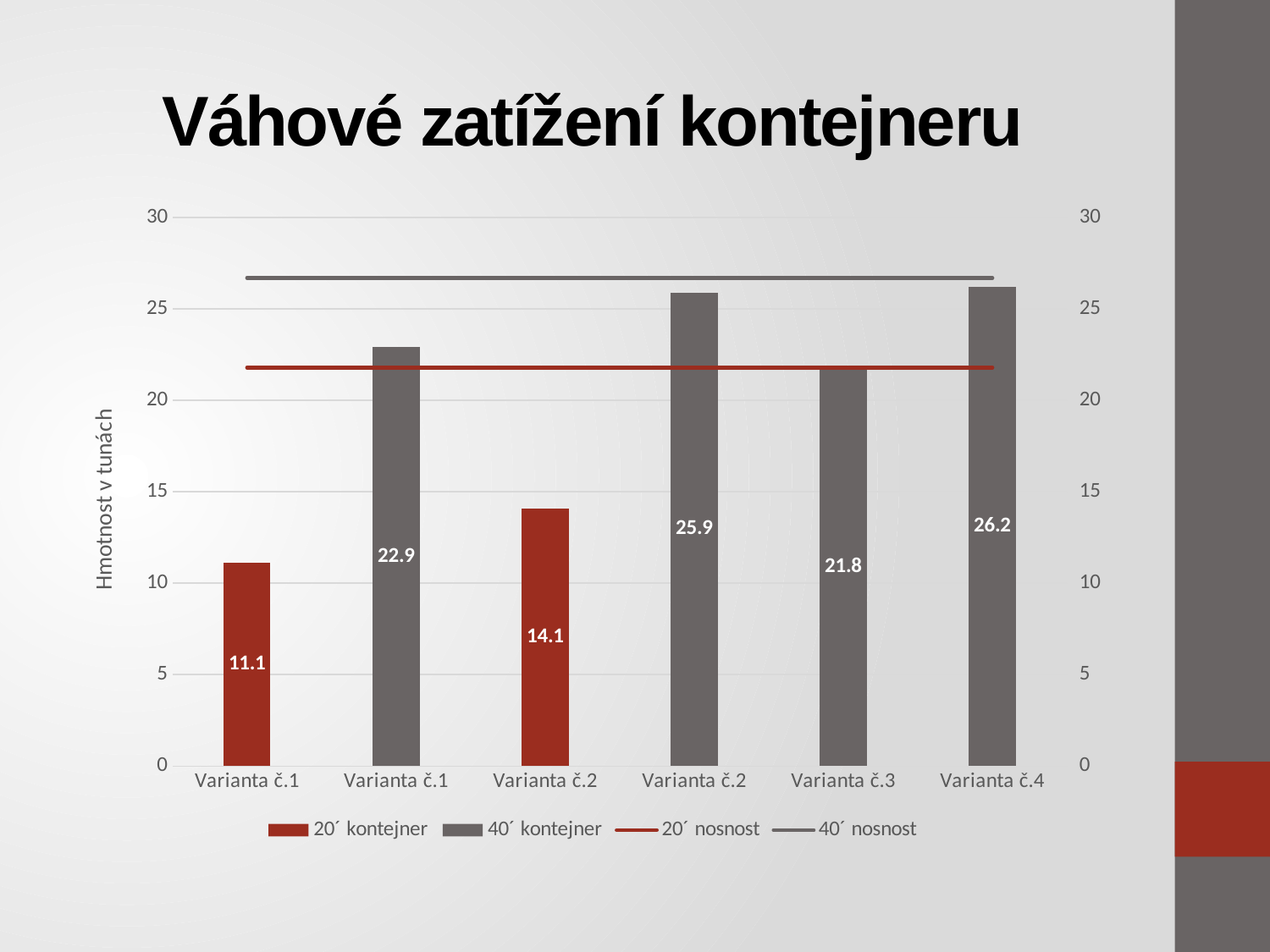
What is the value of the 20´ kontejner bar for Varianta č.1? 11.1 What is the title of the vertical axis? Hmotnost v tunách What is the difference between the 40´ kontejner bar and the 20´ kontejner bar for Varianta č.2? 11.8 What is the value of the 40´ kontejner bar for Varianta č.2? 25.9 What is the value of the 40´ kontejner bar for Varianta č.1? 22.9 How many series does the legend list? 4 Which bar has the highest value in the chart? Varianta č.4 (40´ kontejner) Is the 40´ nosnost line greater or less than 25? greater What is the value of the 20´ kontejner bar for Varianta č.2? 14.1 Which bar has the lowest value in the chart? Varianta č.1 (20´ kontejner) Which is larger: the 40´ kontejner bar for Varianta č.1 or the bar for Varianta č.3? Varianta č.1 (40´ kontejner) What is the value of the 40´ kontejner bar for Varianta č.4? 26.2